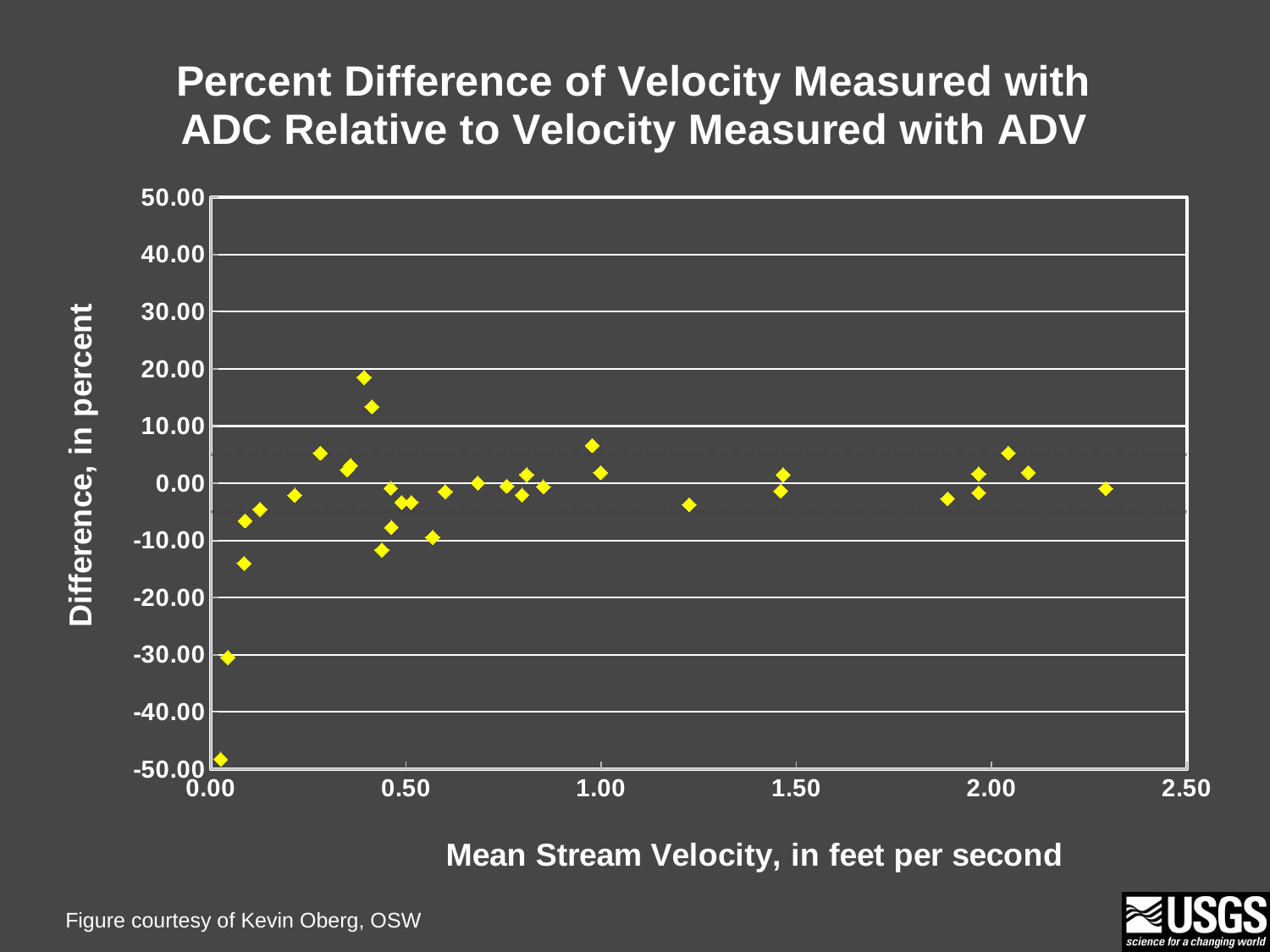
What kind of chart is shown on the slide? scatter chart Is the y value of the lowest point on the chart greater or less than -40.00? less What is the label of the y axis? Difference, in percent Is the y value of the point near a mean stream velocity of 1.23 feet per second greater or less than 0.00? less Is the y value of the point near a mean stream velocity of 0.98 feet per second greater or less than 0.00? greater Which has the larger y value: the highest point near a mean stream velocity of 0.40 feet per second or the point near 2.04 feet per second? the point near 0.40 feet per second Which has the lower y value: the lowest point near a mean stream velocity of 0.02 feet per second or the point near 0.57 feet per second? the point near 0.02 feet per second What is the title of the chart? Percent Difference of Velocity Measured with ADC Relative to Velocity Measured with ADV